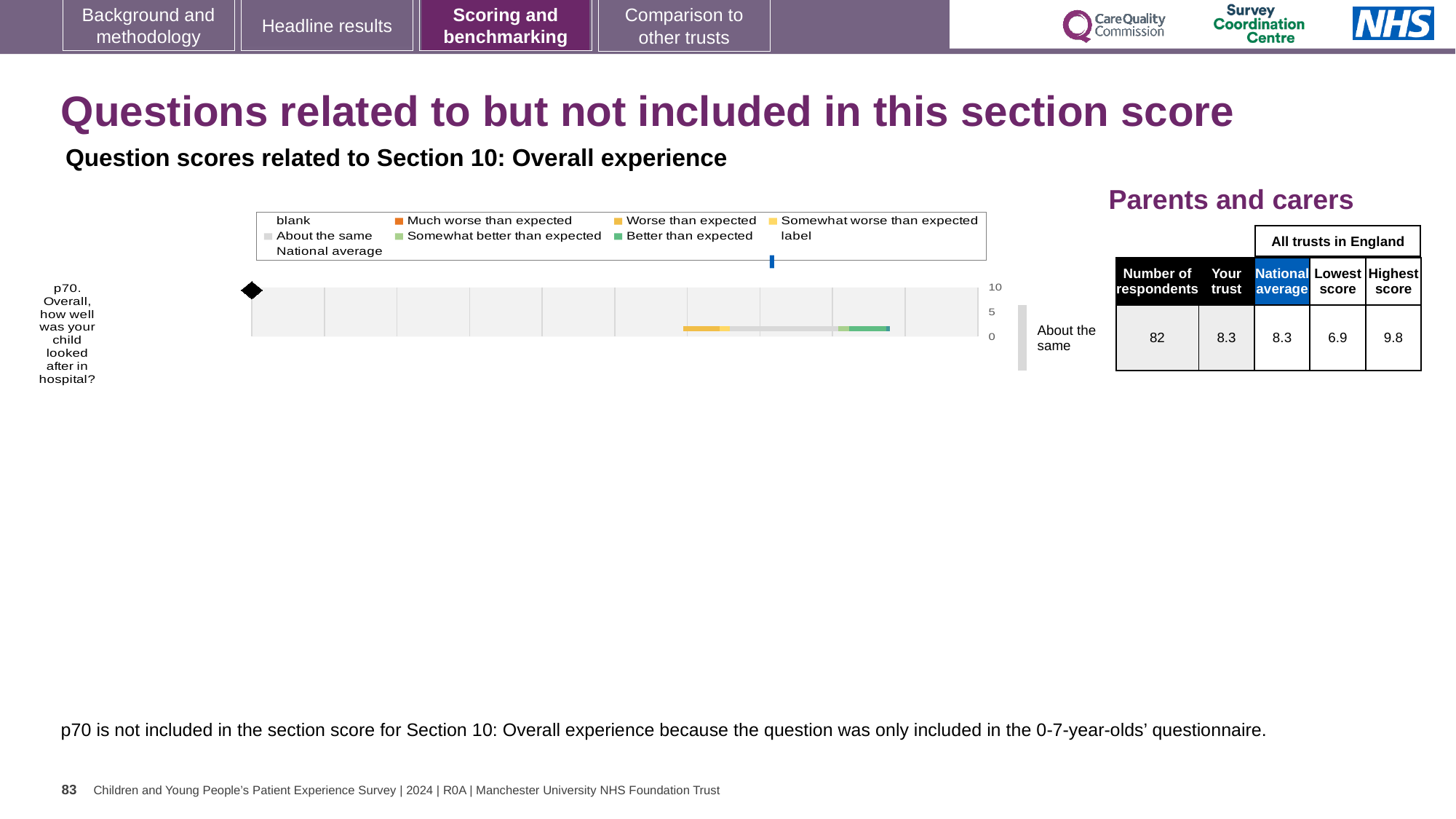
Is the 'Your trust' score for p70 greater or less than 5? greater What is the difference between the highest score and the 'Your trust' score for question p70? 1.5 What is the highest score among all trusts in England for question p70? 9.8 What is the 'Your trust' score for question p70 (Overall, how well was your child looked after in hospital?)? 8.3 What kind of chart is used to show the benchmarking result for p70? bar chart How many questions are plotted in the chart on this slide? 1 What is the difference between the highest score and the lowest score for question p70? 2.9 What is the national average score for question p70? 8.3 Is the 'Your trust' score for p70 higher than, lower than, or the same as the national average? the same How many respondents answered question p70? 82 Which benchmarking category is the trust's result for p70 placed in? About the same What is the lowest score among all trusts in England for question p70? 6.9